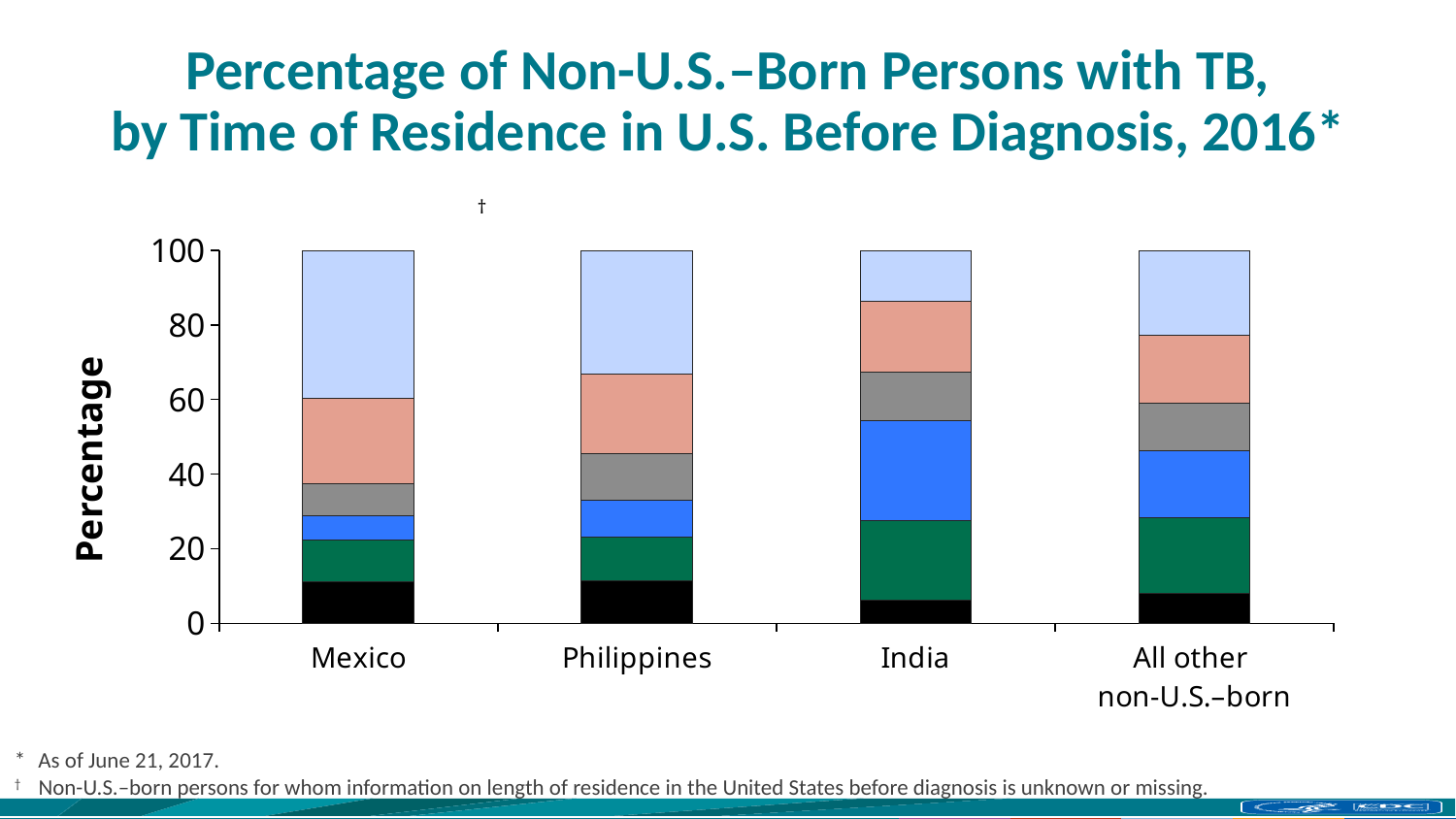
Is the value of the black (bottom) segment in the Mexico bar greater or less than 20? less Which bar has the largest bright blue (middle) segment? India What kind of chart is shown on the slide? Stacked bar chart What is the total height of the stacked bar for Mexico? 100 Is the dark green segment larger for India or for Mexico? India Which bar has the largest light blue (top) segment? Mexico What is the label on the y axis of the chart? Percentage Is the black (bottom) segment larger for Mexico or for India? Mexico How many countries or groups are shown along the x axis of the chart? 4 Is the value of the light blue (top) segment in the Mexico bar greater or less than 20? greater What is the total height of the stacked bar for India? 100 Is the value of the black (bottom) segment in the India bar greater or less than 20? less